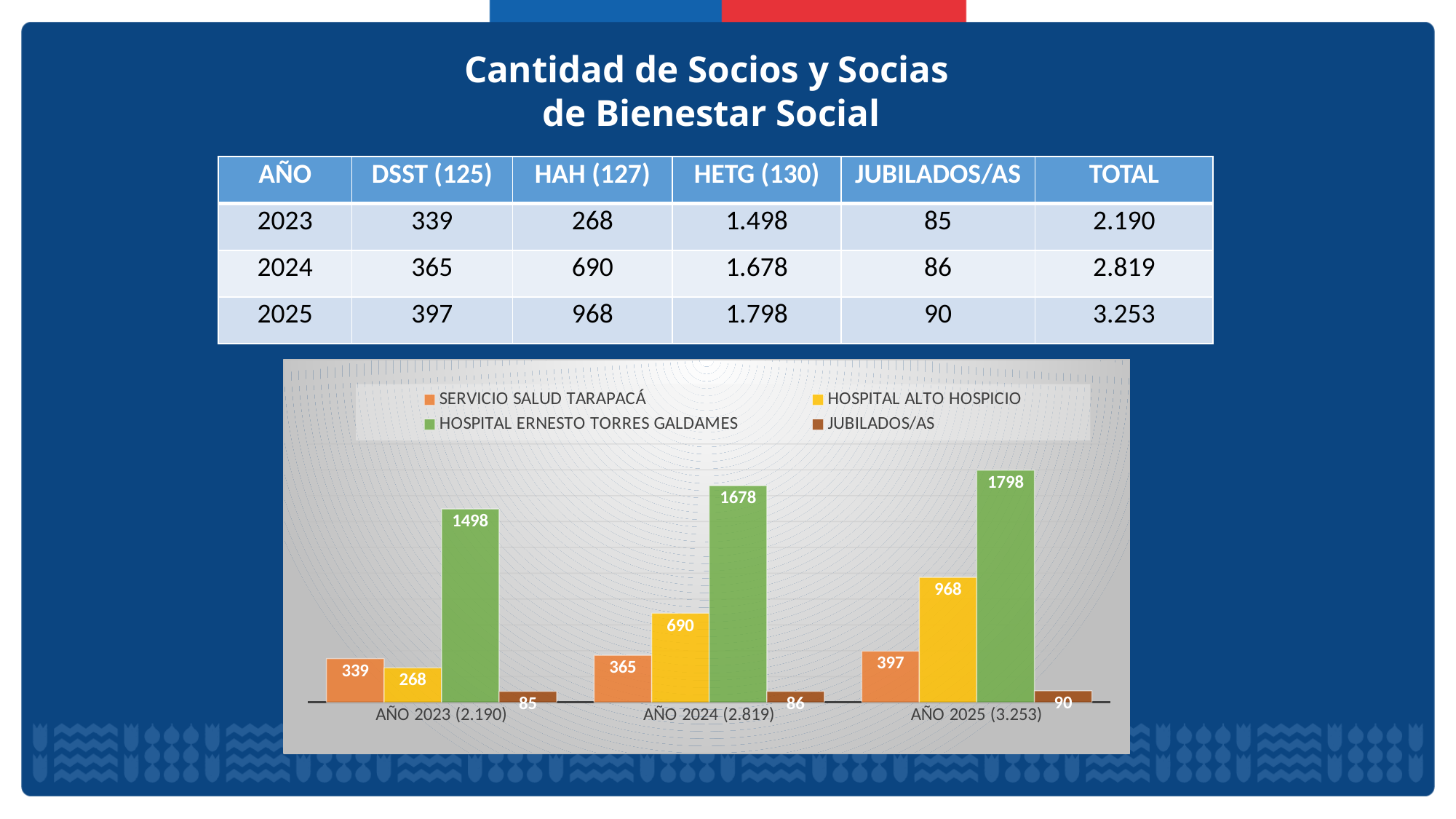
Do the HOSPITAL ERNESTO TORRES GALDAMES values rise or fall from AÑO 2023 to AÑO 2025? Rise Which series has the lowest value in AÑO 2023 (2.190)? JUBILADOS/AS What is the value for SERVICIO SALUD TARAPACÁ in AÑO 2025 (3.253)? 397 What kind of chart is shown on the slide? Bar chart What is the value for HOSPITAL ALTO HOSPICIO in AÑO 2024 (2.819)? 690 Which series has the highest value in AÑO 2024 (2.819)? HOSPITAL ERNESTO TORRES GALDAMES Which is larger: SERVICIO SALUD TARAPACÁ in AÑO 2023 (2.190) or HOSPITAL ALTO HOSPICIO in AÑO 2023 (2.190)? SERVICIO SALUD TARAPACÁ in AÑO 2023 (2.190) What is the value for JUBILADOS/AS in AÑO 2025 (3.253)? 90 How many series does the chart legend list? 4 What is the value for HOSPITAL ERNESTO TORRES GALDAMES in AÑO 2023 (2.190)? 1498 What is the difference between the HOSPITAL ALTO HOSPICIO values for AÑO 2025 (3.253) and AÑO 2024 (2.819)? 278 How many year categories are shown on the x axis of the chart? 3